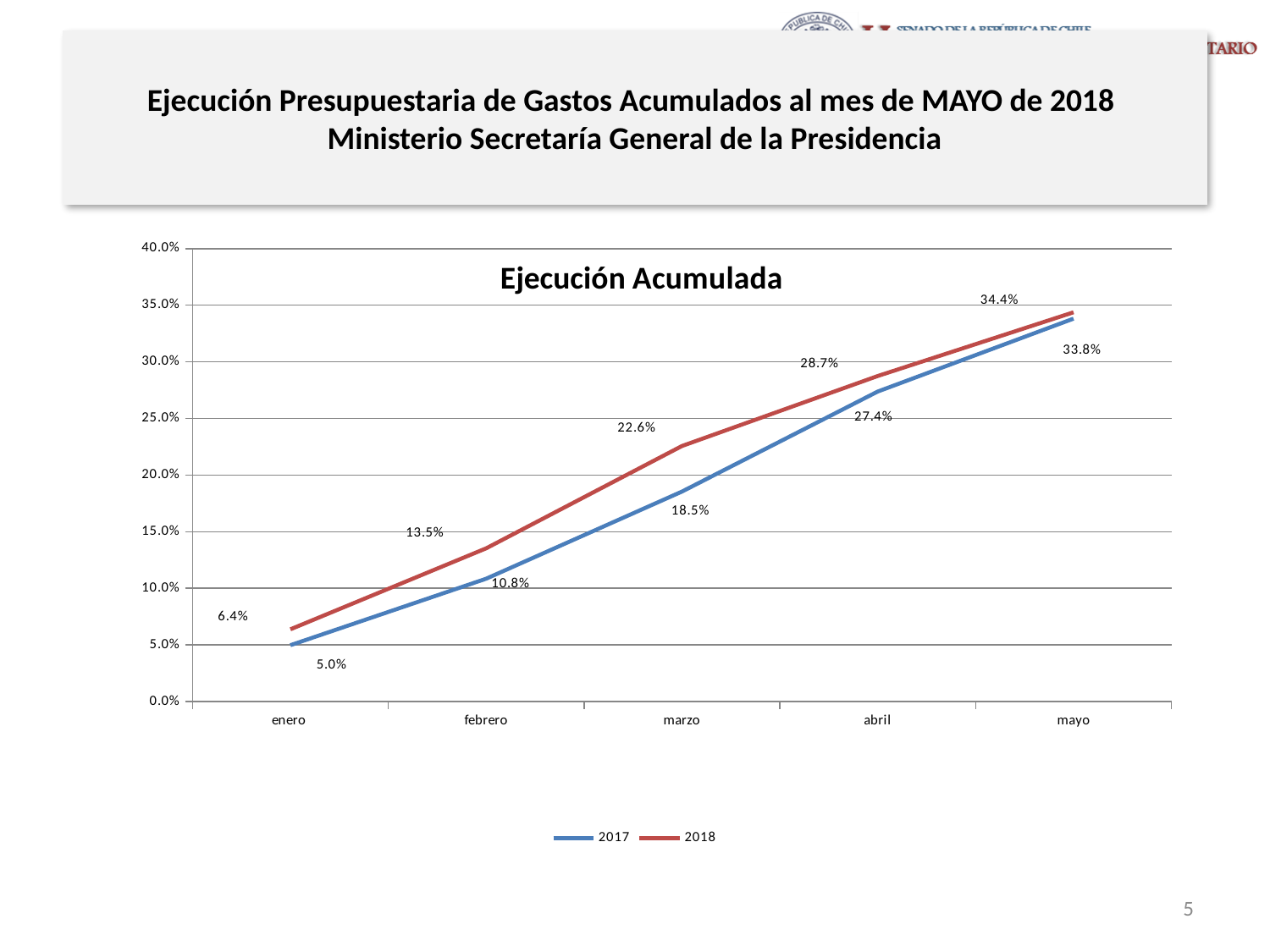
How many series does the legend list? 2 How many months are shown on the x axis? 5 Do the values for 2017 rise or fall from enero to mayo? rise In which month is the 2017 series lowest? enero Which series has the larger value in marzo, 2017 or 2018? 2018 What is the value for 2017 in febrero? 10.8% In which month is the 2018 series highest? mayo What is the value for 2018 in marzo? 22.6% What type of chart is shown on the slide? line chart What is the difference between the 2018 and 2017 values in abril? 1.3% What is the value for 2018 in mayo? 34.4% What is the title of the chart? Ejecución Acumulada